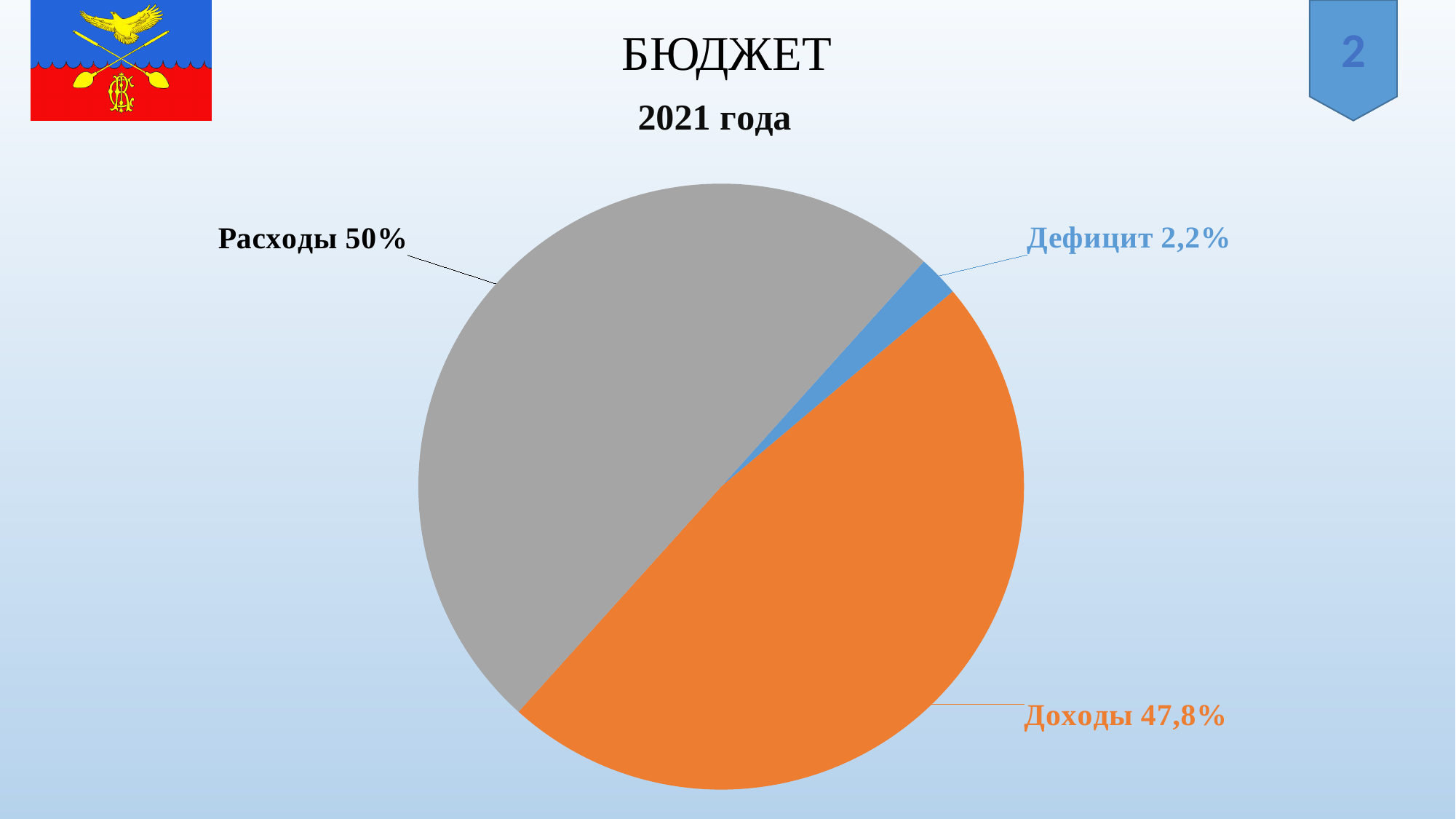
What colour is the Доходы slice? Orange What share of the pie does Доходы take? 47,8% Which slice of the pie is the largest? Расходы What share of the pie does Дефицит take? 2,2% What share of the pie does Расходы take? 50% What year does the chart title refer to? 2021 What is the difference between the Расходы share and the Доходы share? 2,2% What kind of chart is shown on the slide? Pie chart How many slices does the pie chart have? 3 Which slice of the pie is the smallest? Дефицит What is the difference between the Доходы share and the Дефицит share? 45,6% Which is larger, the Доходы slice or the Дефицит slice? Доходы